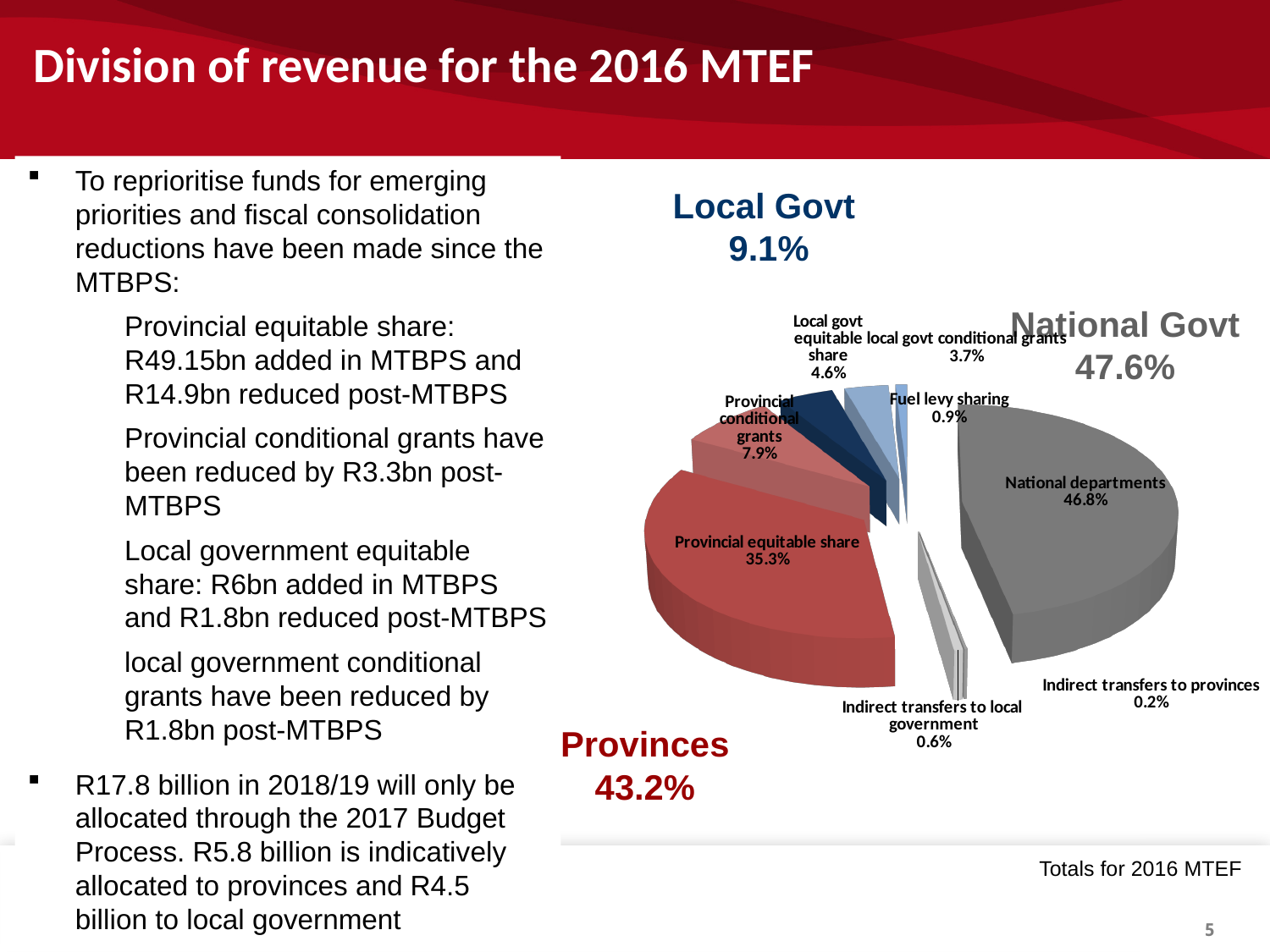
Which slice of the pie is the largest? National departments What share of the pie is labelled for Indirect transfers to local government? 0.6% What kind of chart is shown on the slide? pie chart Which slice of the pie is the smallest? Indirect transfers to provinces What share of the pie is labelled for Fuel levy sharing? 0.9% What share of the pie is labelled for Provincial equitable share? 35.3% What is the difference in percentage points between the National departments slice and the Provincial equitable share slice? 11.5 How many slices does the pie chart have? 8 What share of the pie is labelled for National departments? 46.8% What share of the pie is labelled for Provincial conditional grants? 7.9% What percentage is shown next to the National Govt group label on the chart? 47.6% Which is larger: the Local govt equitable share slice or the local govt conditional grants slice? Local govt equitable share